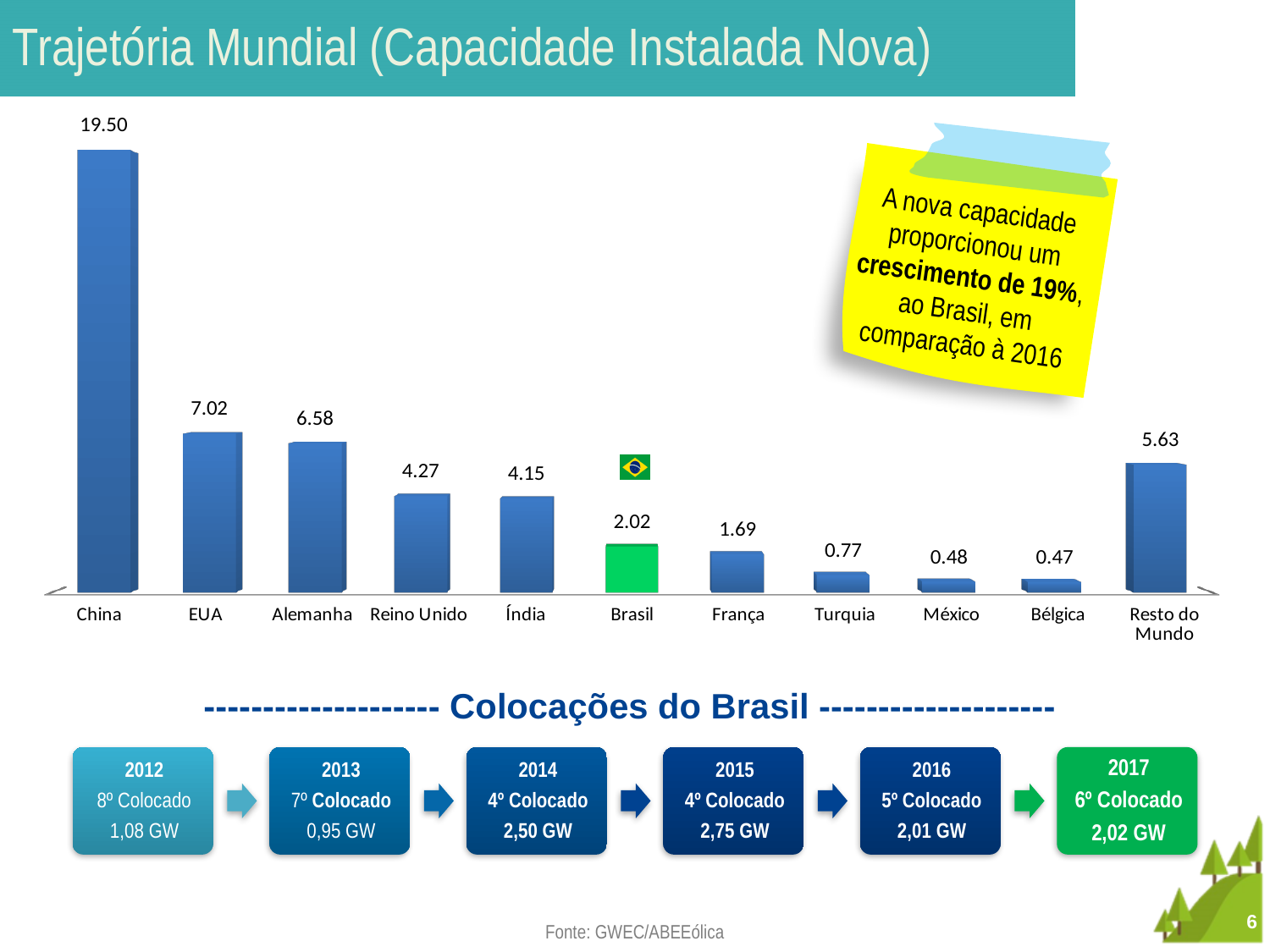
Which bar is coloured green instead of blue? Brasil What is the value for China? 19.50 Which is larger, the value for Reino Unido or the value for Índia? Reino Unido Which is larger, the value for Resto do Mundo or the value for Brasil? Resto do Mundo Which category has the highest value? China What is the value for Resto do Mundo? 5.63 What type of chart is shown on the slide? bar chart What is the difference between the values for EUA and Alemanha? 0.44 How many categories are shown on the x axis? 11 What is the value for Brasil? 2.02 What is the difference between the values for China and EUA? 12.48 What is the value for Turquia? 0.77